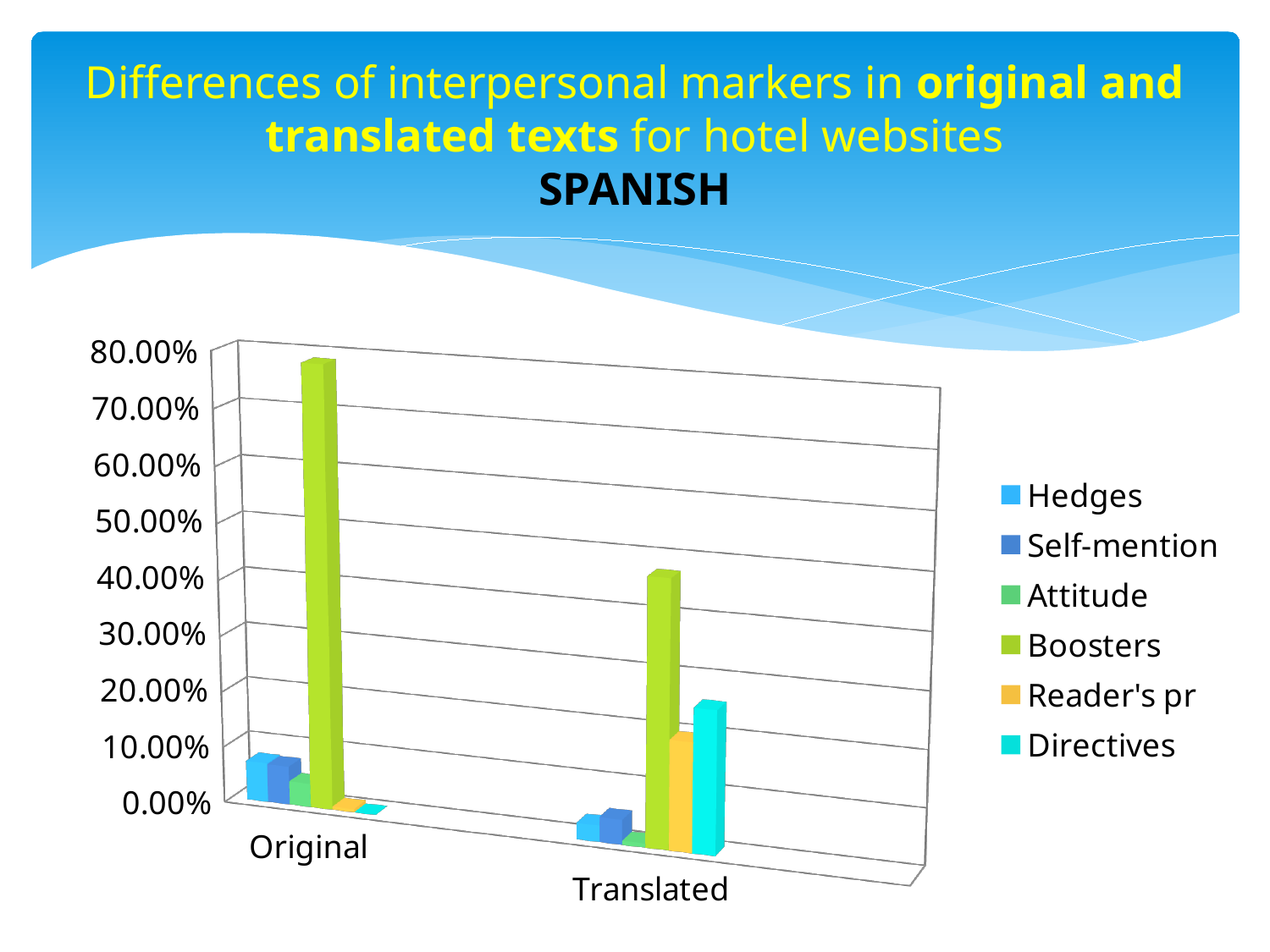
How many series does the chart's legend list? 6 Which language is named in the slide title? SPANISH Does the Boosters value rise or fall from Original to Translated? fall What kind of chart is shown on the slide? bar chart Which series has the highest value in the Translated category? Boosters Which is larger, the Directives value for Original or the Directives value for Translated? Translated How many categories are shown on the x axis of the chart? 2 Is the value for Boosters in the Original category greater or less than 70.00%? greater Is the value for Boosters in the Translated category greater or less than 30.00%? greater Is the value for Directives in the Translated category greater or less than 30.00%? less Which series has the highest value in the Original category? Boosters Which is larger, the Boosters value for Original or the Boosters value for Translated? Original